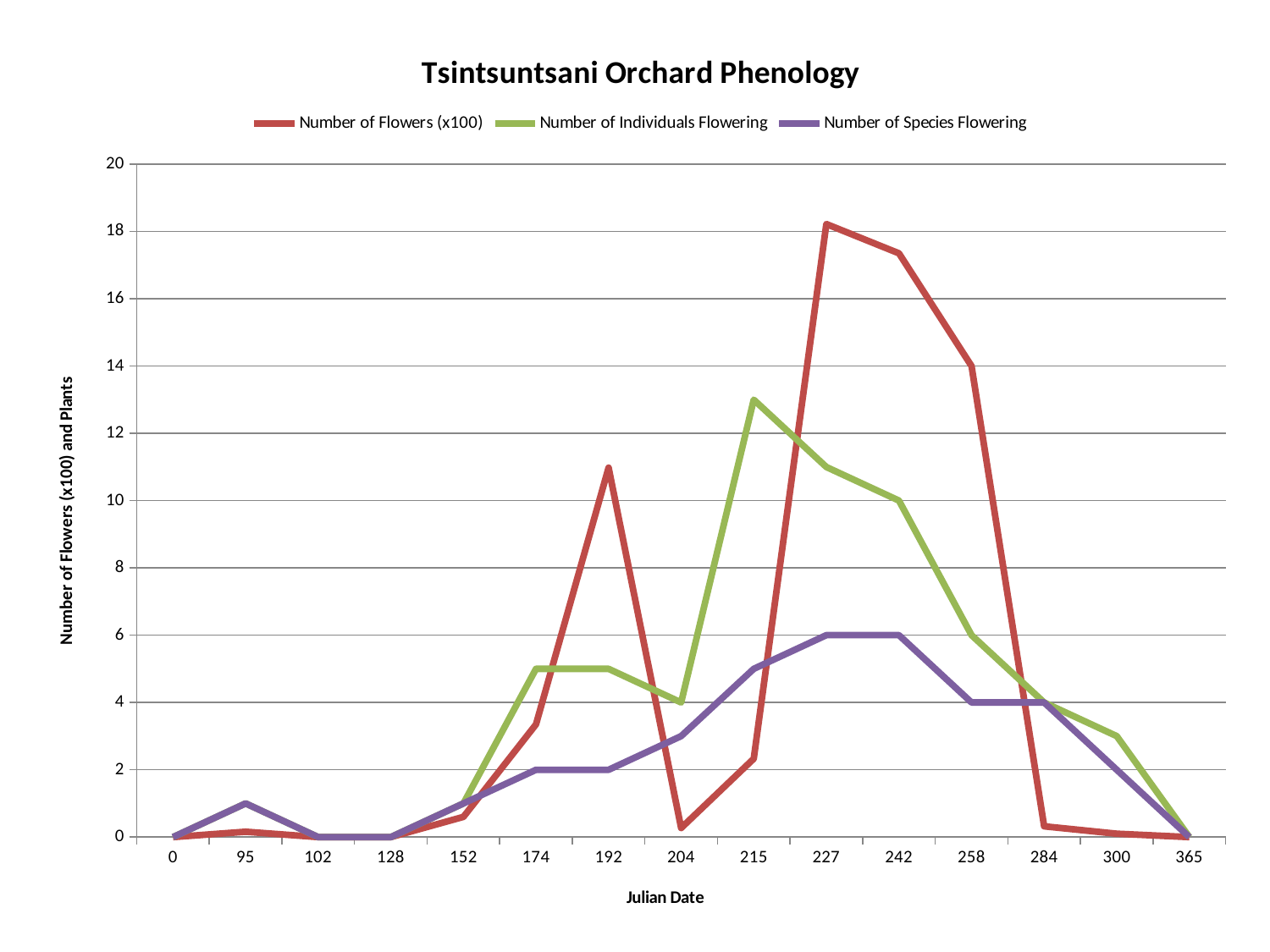
What is the Number of Species Flowering at Julian Date 227? 6 At which Julian Date does the Number of Individuals Flowering reach its highest value? 215 What is the title of the chart? Tsintsuntsani Orchard Phenology At which Julian Date does the Number of Flowers (x100) reach its highest value? 227 How many series does the legend list? 3 Is the Number of Flowers (x100) at Julian Date 227 greater or less than 18? greater How many Julian Date categories are shown on the x axis? 15 Which is larger at Julian Date 242: Number of Flowers (x100) or Number of Individuals Flowering? Number of Flowers (x100) What type of chart is shown on the slide? line chart